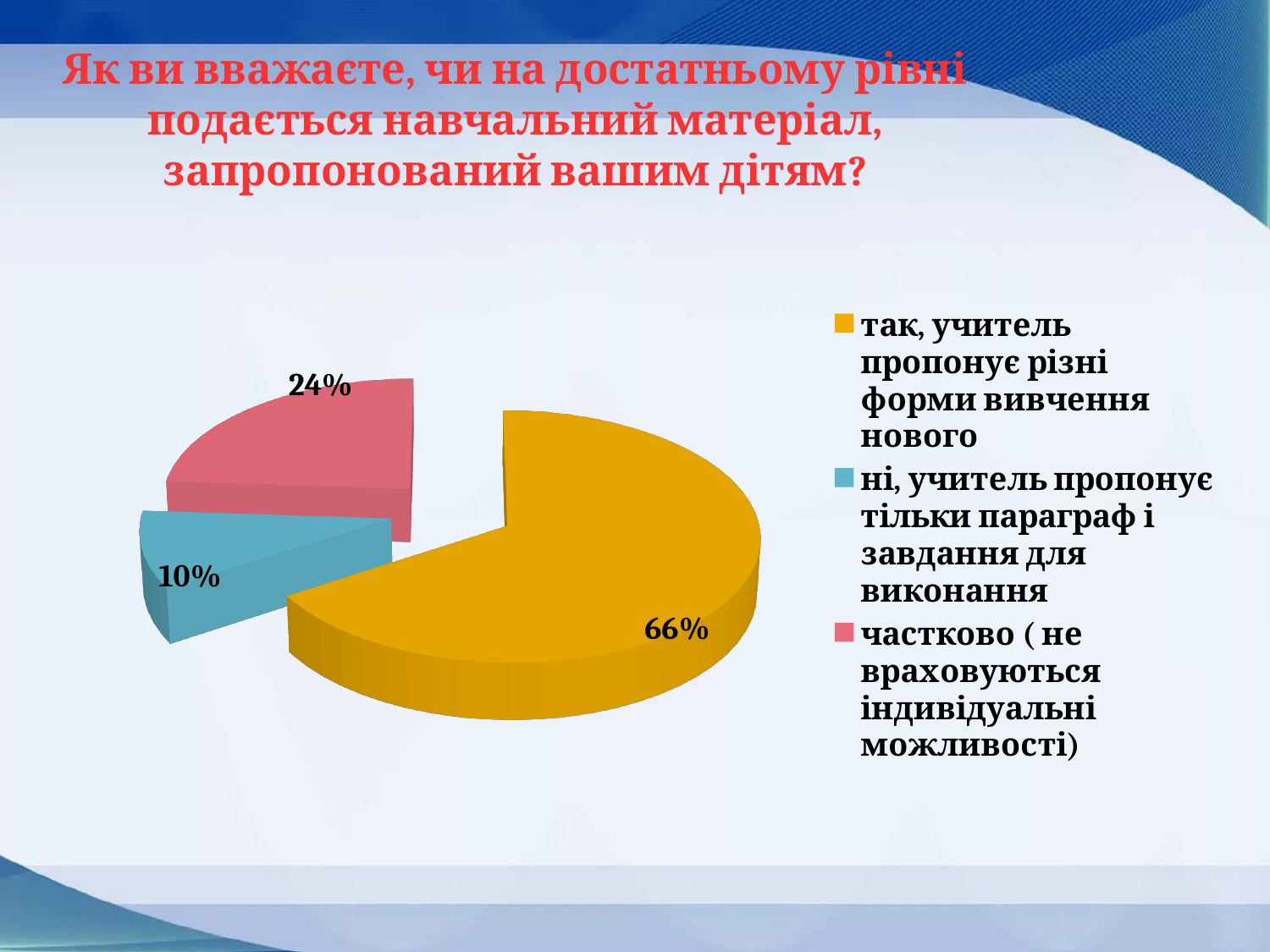
How many entries does the legend list? 3 What kind of chart is shown on the slide? pie chart Which slice is larger: "частково" or "ні"? частково How many slices does the pie chart have? 3 Which category has the largest slice of the pie? так, учитель пропонує різні форми вивчення нового What colour is the slice for "ні, учитель пропонує тільки параграф і завдання для виконання"? blue What is the difference in percentage points between the "так" slice and the "частково" slice? 42 What share of the pie is labelled for the category "ні, учитель пропонує тільки параграф і завдання для виконання"? 10% Which category has the smallest slice of the pie? ні, учитель пропонує тільки параграф і завдання для виконання What is the difference in percentage points between the "частково" slice and the "ні" slice? 14 What share of the pie is labelled for the category "частково (не враховуються індивідуальні можливості)"? 24% What share of the pie is labelled for the category "так, учитель пропонує різні форми вивчення нового"? 66%